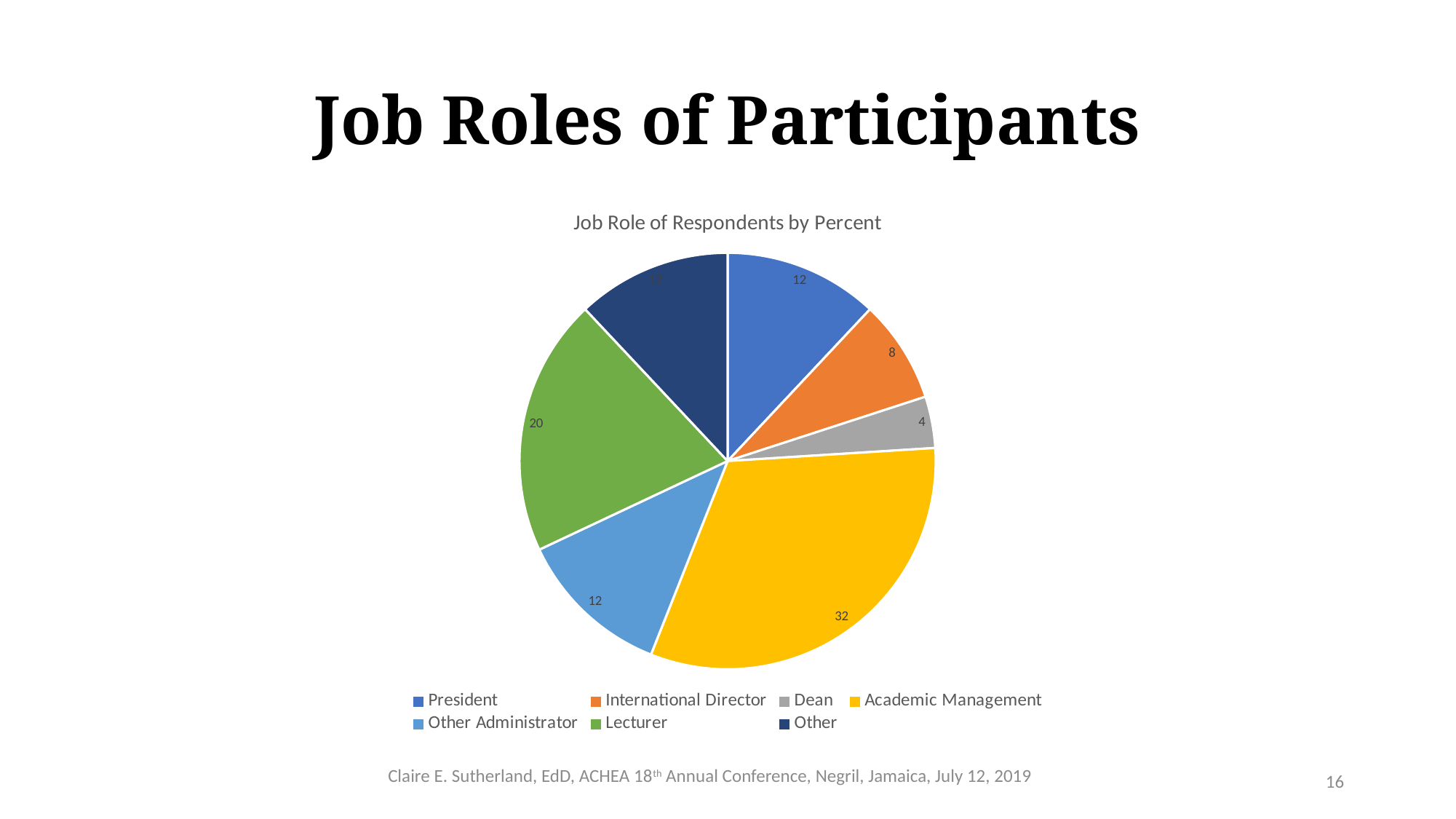
What is the chart's title? Job Role of Respondents by Percent What is the value shown for President? 12 Which job role has the smallest slice of the pie? Dean What is the value shown for International Director? 8 Which is larger, the slice for Lecturer or the slice for Other Administrator? Lecturer What type of chart is shown on the slide? Pie chart How many job role categories does the pie chart show? 7 What colour is the Academic Management slice? Yellow What is the difference between the values for Academic Management and Lecturer? 12 Which job role has the largest slice of the pie? Academic Management What is the value shown for Academic Management? 32 What is the value shown for Lecturer? 20